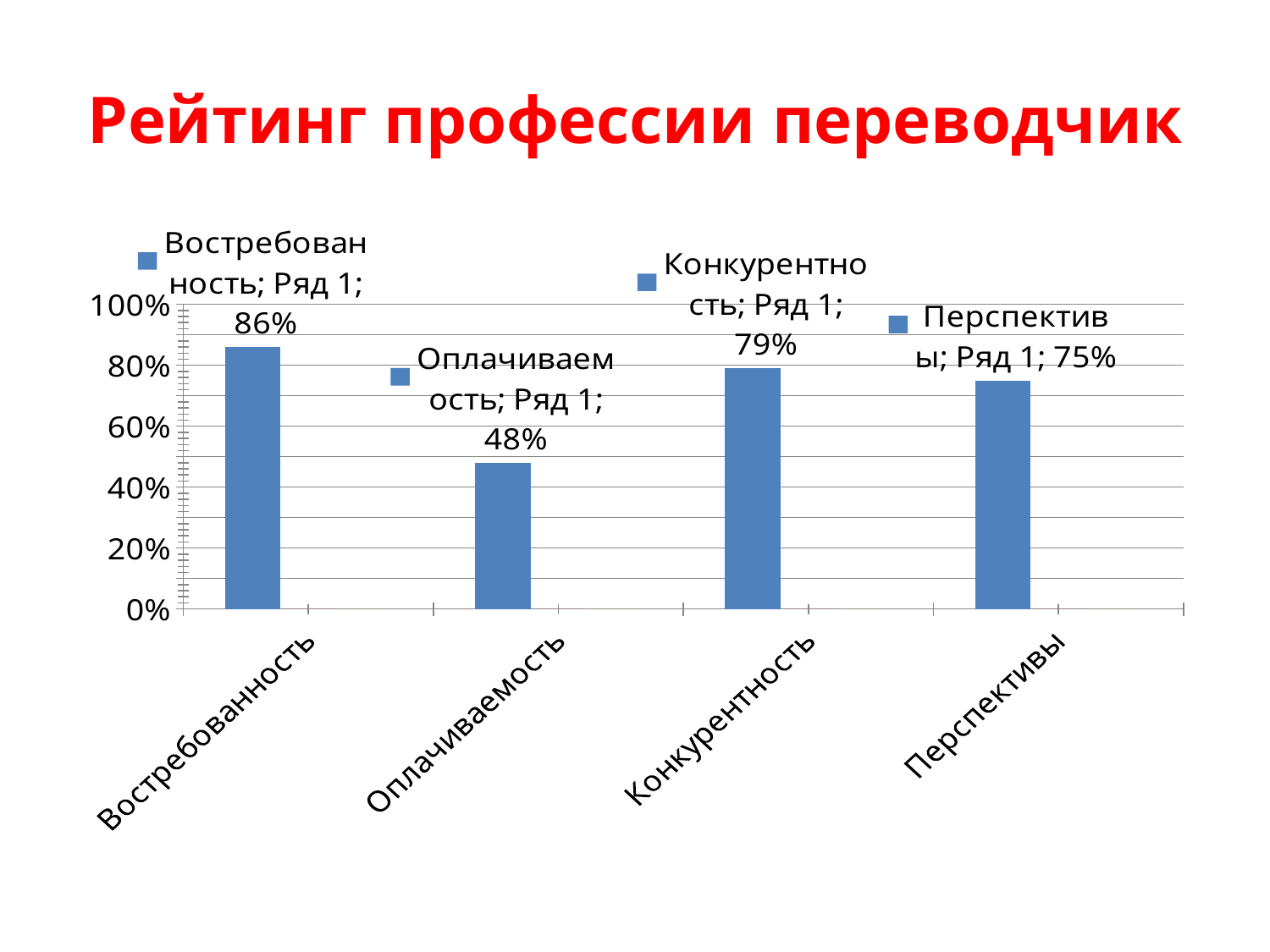
What is the value for Перспективы? 75% Which is larger, the value for Конкурентность or the value for Оплачиваемость? Конкурентность What is the title of the slide? Рейтинг профессии переводчик Which category has the highest value? Востребованность What is the value for Востребованность? 86% How many categories are shown on the chart? 4 What is the value for Конкурентность? 79% What is the value for Оплачиваемость? 48% What is the difference between the values for Востребованность and Оплачиваемость? 38% Which category has the lowest value? Оплачиваемость What kind of chart is shown on the slide? Bar chart What is the difference between the values for Конкурентность and Перспективы? 4%